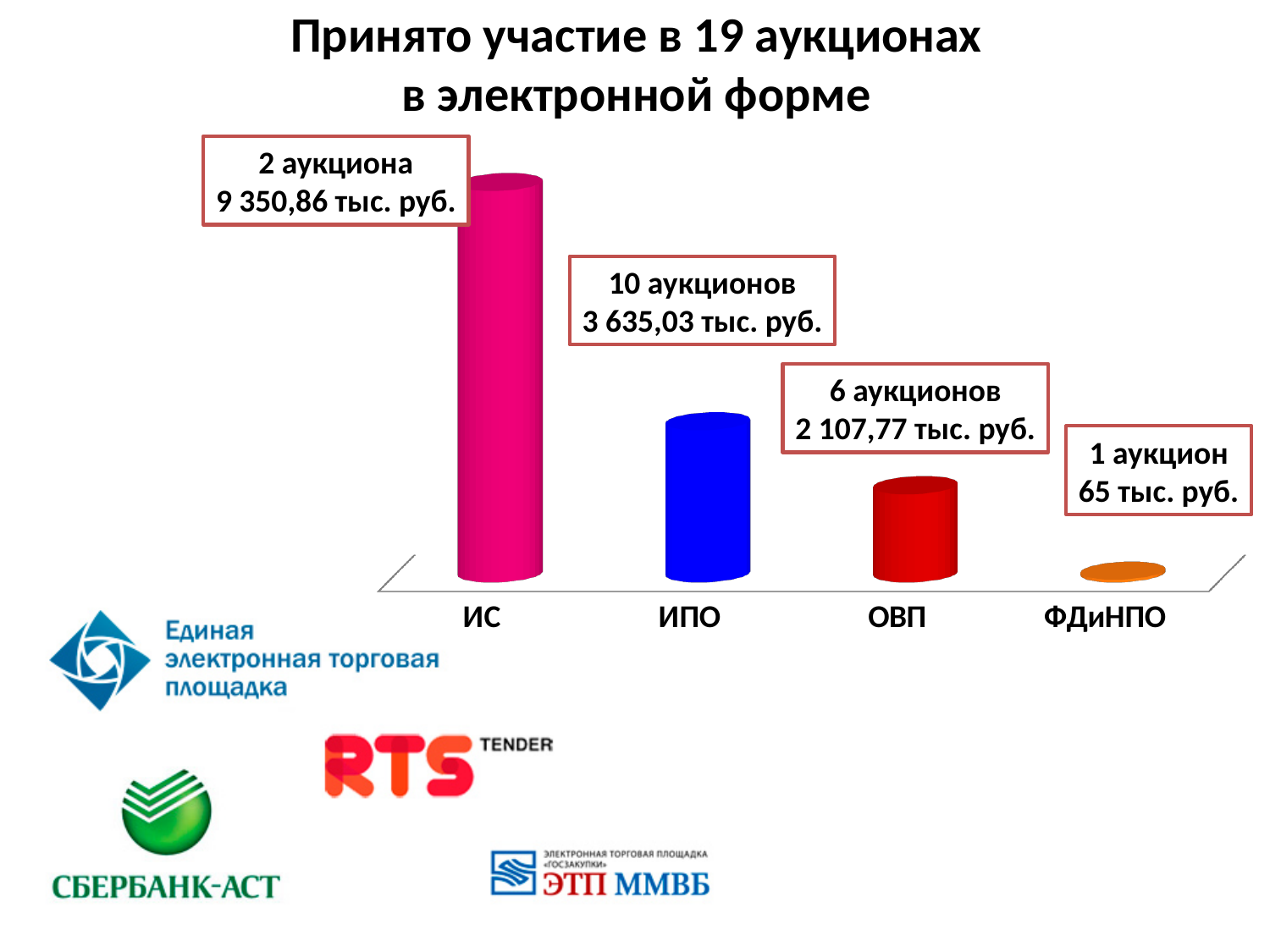
What is the value shown for ИПО? 3 635,03 тыс. руб. What kind of chart is shown on the slide? Bar chart How many categories are shown on the x axis? 4 What is the value shown for ИС? 9 350,86 тыс. руб. How many auctions are shown for ИПО? 10 аукционов What is the title of the slide? Принято участие в 19 аукционах в электронной форме What is the difference between the values for ИС and ИПО? 5 715,83 тыс. руб. Which is larger, the value for ИПО or the value for ОВП? ИПО Which category has the lowest value? ФДиНПО What is the value shown for ФДиНПО? 65 тыс. руб. Which category has the highest value? ИС What is the value shown for ОВП? 2 107,77 тыс. руб.